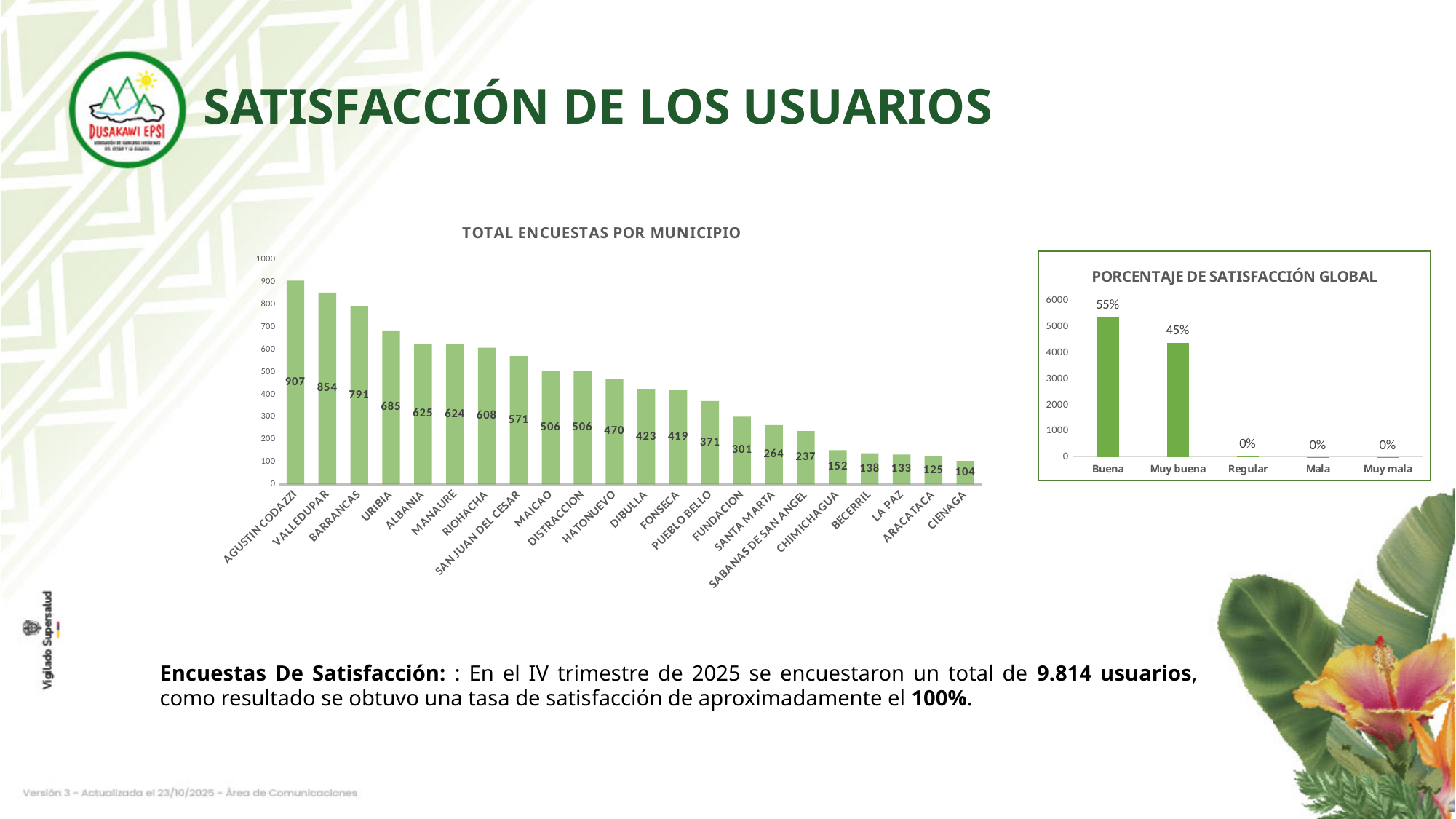
In the chart 'TOTAL ENCUESTAS POR MUNICIPIO', which municipality has the highest value? AGUSTIN CODAZZI In the chart 'TOTAL ENCUESTAS POR MUNICIPIO', what is the difference between the values for AGUSTIN CODAZZI and BARRANCAS? 116 In the chart 'TOTAL ENCUESTAS POR MUNICIPIO', do the values rise or fall from left to right? fall In the chart 'PORCENTAJE DE SATISFACCIÓN GLOBAL', is the bar for 'Buena' greater or less than 5000 on the axis? greater In the chart 'PORCENTAJE DE SATISFACCIÓN GLOBAL', what is the label shown for 'Muy buena'? 45% In the chart 'TOTAL ENCUESTAS POR MUNICIPIO', how many municipalities are shown? 22 In the chart 'PORCENTAJE DE SATISFACCIÓN GLOBAL', which category has the highest value? Buena In the chart 'TOTAL ENCUESTAS POR MUNICIPIO', which municipality has the lowest value? CIENAGA What kind of chart is 'PORCENTAJE DE SATISFACCIÓN GLOBAL'? bar chart In the chart 'TOTAL ENCUESTAS POR MUNICIPIO', which has a larger value, FONSECA or PUEBLO BELLO? FONSECA In the chart 'TOTAL ENCUESTAS POR MUNICIPIO', what is the value for RIOHACHA? 608 In the chart 'TOTAL ENCUESTAS POR MUNICIPIO', what is the value for VALLEDUPAR? 854